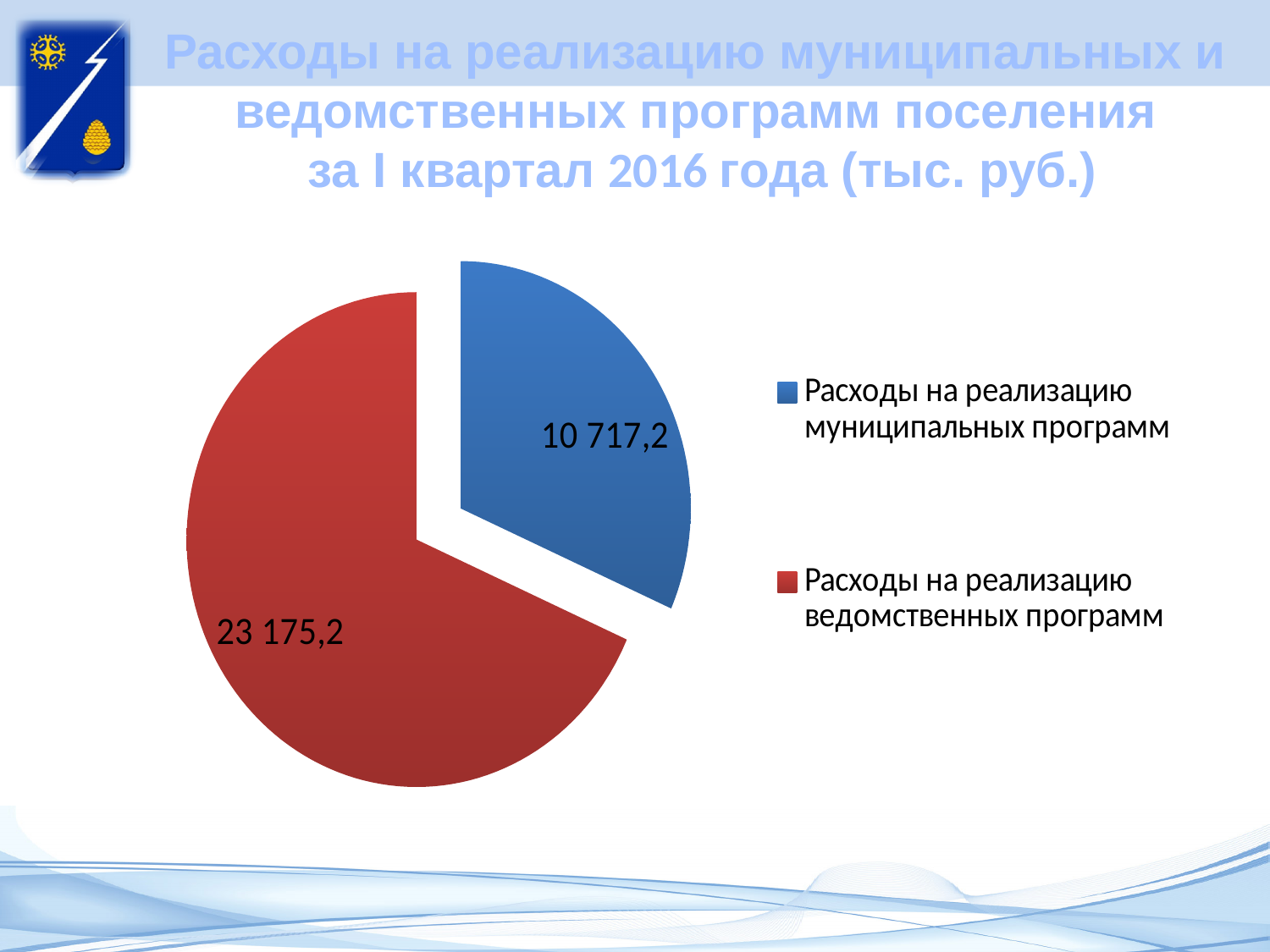
Which is larger: the value for «Расходы на реализацию муниципальных программ» or the value for «Расходы на реализацию ведомственных программ»? Расходы на реализацию ведомственных программ Which category has the smallest slice of the pie chart? Расходы на реализацию муниципальных программ What colour is the slice for «Расходы на реализацию ведомственных программ»? Red How many entries does the legend of the chart list? 2 What value is shown for «Расходы на реализацию ведомственных программ» in the pie chart? 23 175,2 How many slices does the pie chart have? 2 What is the difference between the value for «Расходы на реализацию ведомственных программ» and the value for «Расходы на реализацию муниципальных программ»? 12 458,0 What share of the pie does «Расходы на реализацию муниципальных программ» represent, to one decimal place? 31.6% What value is shown for «Расходы на реализацию муниципальных программ» in the pie chart? 10 717,2 Which category has the largest slice of the pie chart? Расходы на реализацию ведомственных программ What is the total of the two values shown in the pie chart? 33 892,4 What kind of chart is shown on the slide? Pie chart